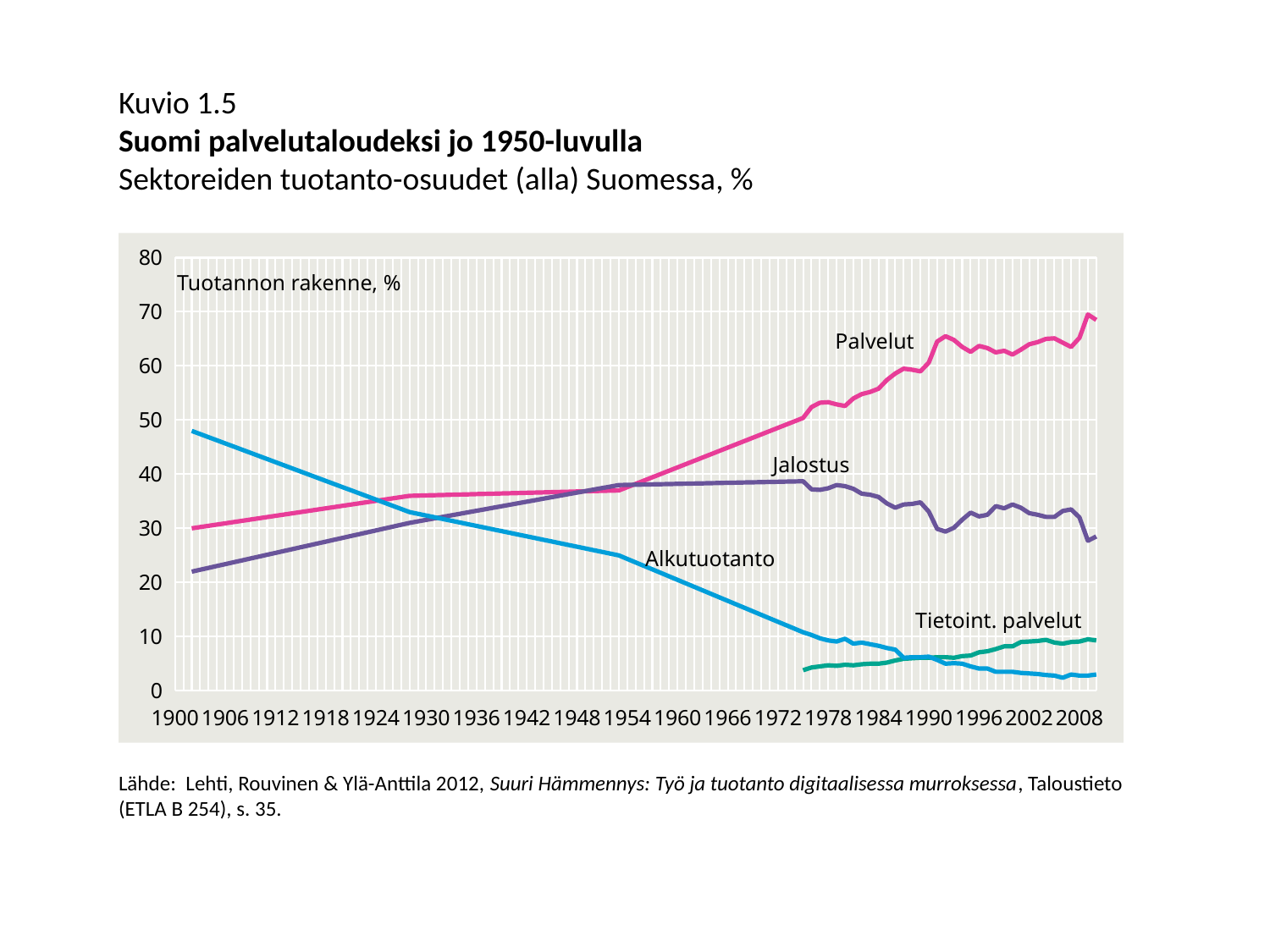
Is the value for Palvelut in 2008 greater or less than 60? greater In 2008, which is larger: Palvelut or Jalostus? Palvelut What label is printed inside the plot area in the top-left corner of the chart? Tuotannon rakenne, % In 1900, which is larger: Alkutuotanto or Palvelut? Alkutuotanto Which series has the lowest value in 2008? Alkutuotanto Is the value for Jalostus in 1900 greater or less than 30? less What kind of chart is shown on the slide? line chart Is the value for Alkutuotanto in 1900 greater or less than 40? greater Which series has the highest value in 2008? Palvelut Does the Palvelut line rise or fall from 1900 to 2008? rise How many series are labelled on the chart? 4 Does the Alkutuotanto line rise or fall from 1900 to 2008? fall